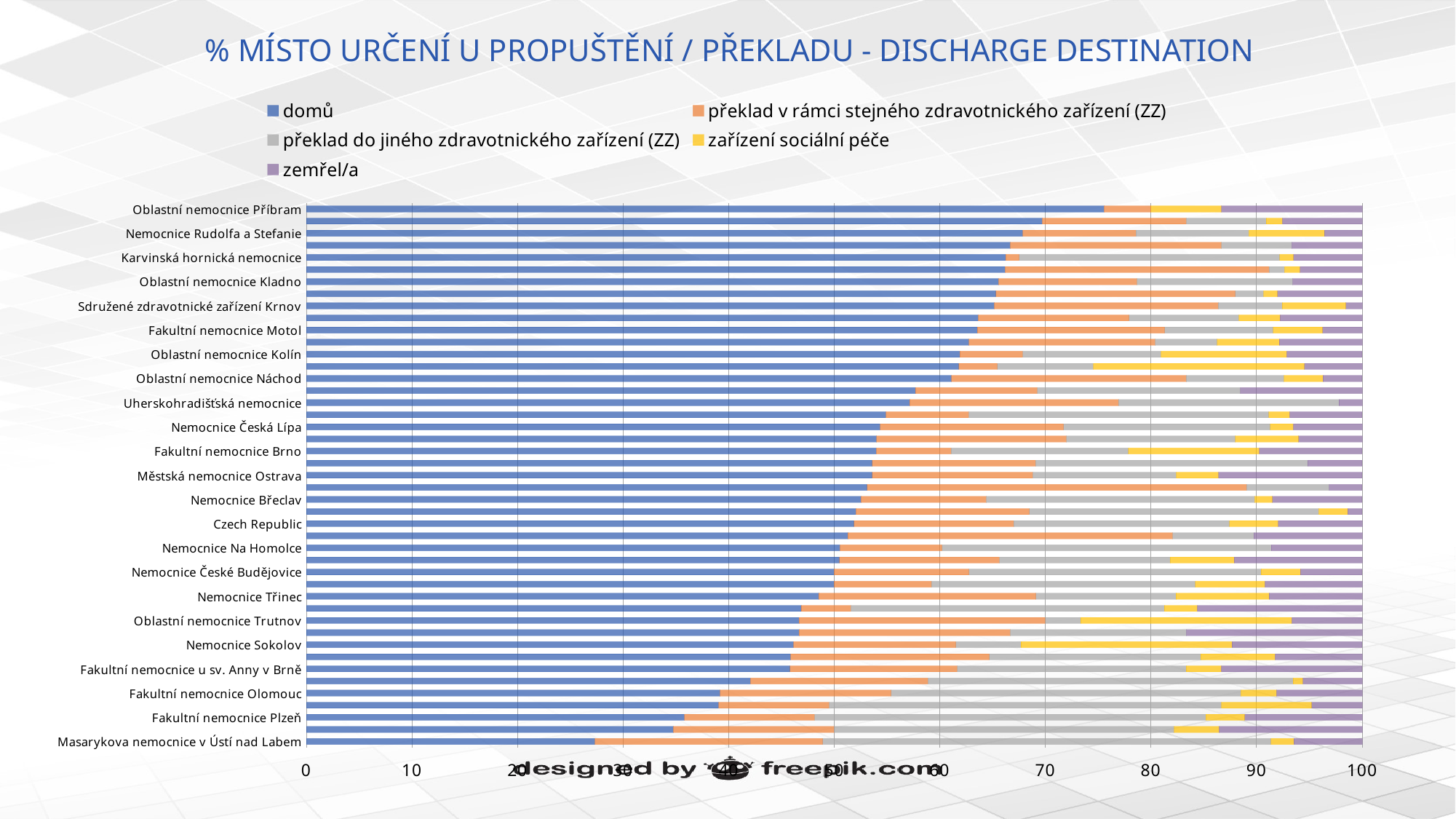
Is the "domů" value for Nemocnice Třinec greater or less than 50? less What is the title of the chart? % MÍSTO URČENÍ U PROPUŠTĚNÍ / PŘEKLADU - DISCHARGE DESTINATION Is the "domů" value for Fakultní nemocnice Plzeň greater or less than 40? less Is the "domů" value for Oblastní nemocnice Příbram greater or less than 70? greater What kind of chart is shown on the slide? Stacked bar chart Which has a larger "domů" share: Oblastní nemocnice Příbram or Fakultní nemocnice Plzeň? Oblastní nemocnice Příbram Which hospital has the lowest share for "domů"? Masarykova nemocnice v Ústí nad Labem How many series does the legend list? 5 Which hospital has the highest share for "domů"? Oblastní nemocnice Příbram Which series is shown in purple? zemřel/a Do the "domů" shares increase or decrease going from the top bar to the bottom bar? decrease